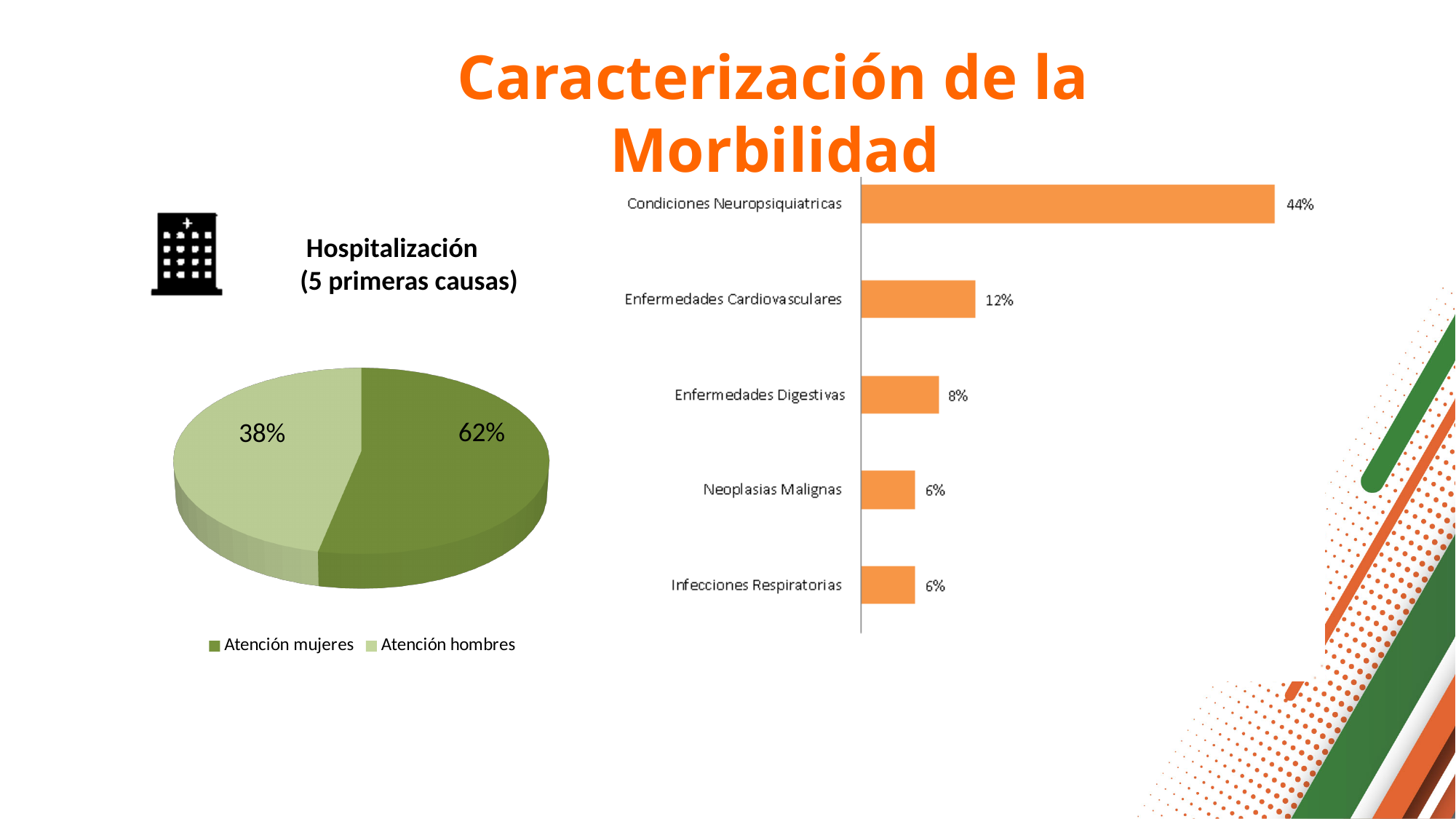
How many categories are shown in the bar chart on the right? 5 What kind of chart is on the right side of the slide? Bar chart In the pie chart on the left, what share is Atención mujeres? 62% In the bar chart on the right, what is the value for Enfermedades Digestivas? 8% In the bar chart on the right, what is the value for Condiciones Neuropsiquiatricas? 44% In the bar chart on the right, which is larger, Enfermedades Digestivas or Neoplasias Malignas? Enfermedades Digestivas In the pie chart on the left, what share is Atención hombres? 38% In the bar chart on the right, what is the difference between Condiciones Neuropsiquiatricas and Enfermedades Cardiovasculares? 32% In the bar chart on the right, which category has the highest value? Condiciones Neuropsiquiatricas In the bar chart on the right, what is the value for Enfermedades Cardiovasculares? 12% How many series does the legend of the pie chart on the left list? 2